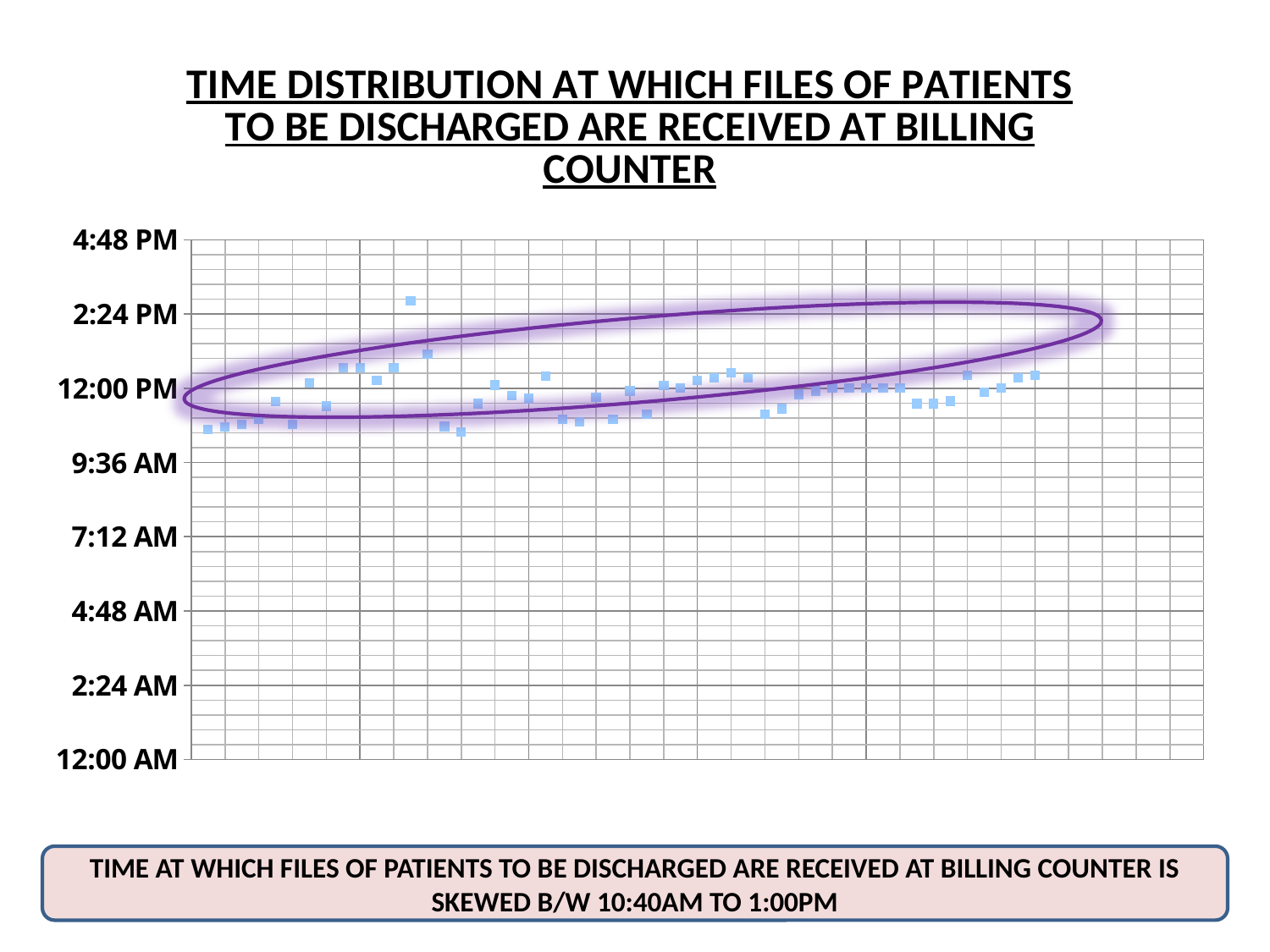
What kind of chart is shown on the slide? Scatter chart Is the highest plotted point on the chart greater or less than 2:24 PM? greater Are any of the plotted points on the chart below 7:12 AM? No What is the highest tick label shown on the vertical axis of the chart? 4:48 PM Is the lowest plotted point on the chart greater or less than 9:36 AM? greater What is the title of the chart on the slide? TIME DISTRIBUTION AT WHICH FILES OF PATIENTS TO BE DISCHARGED ARE RECEIVED AT BILLING COUNTER